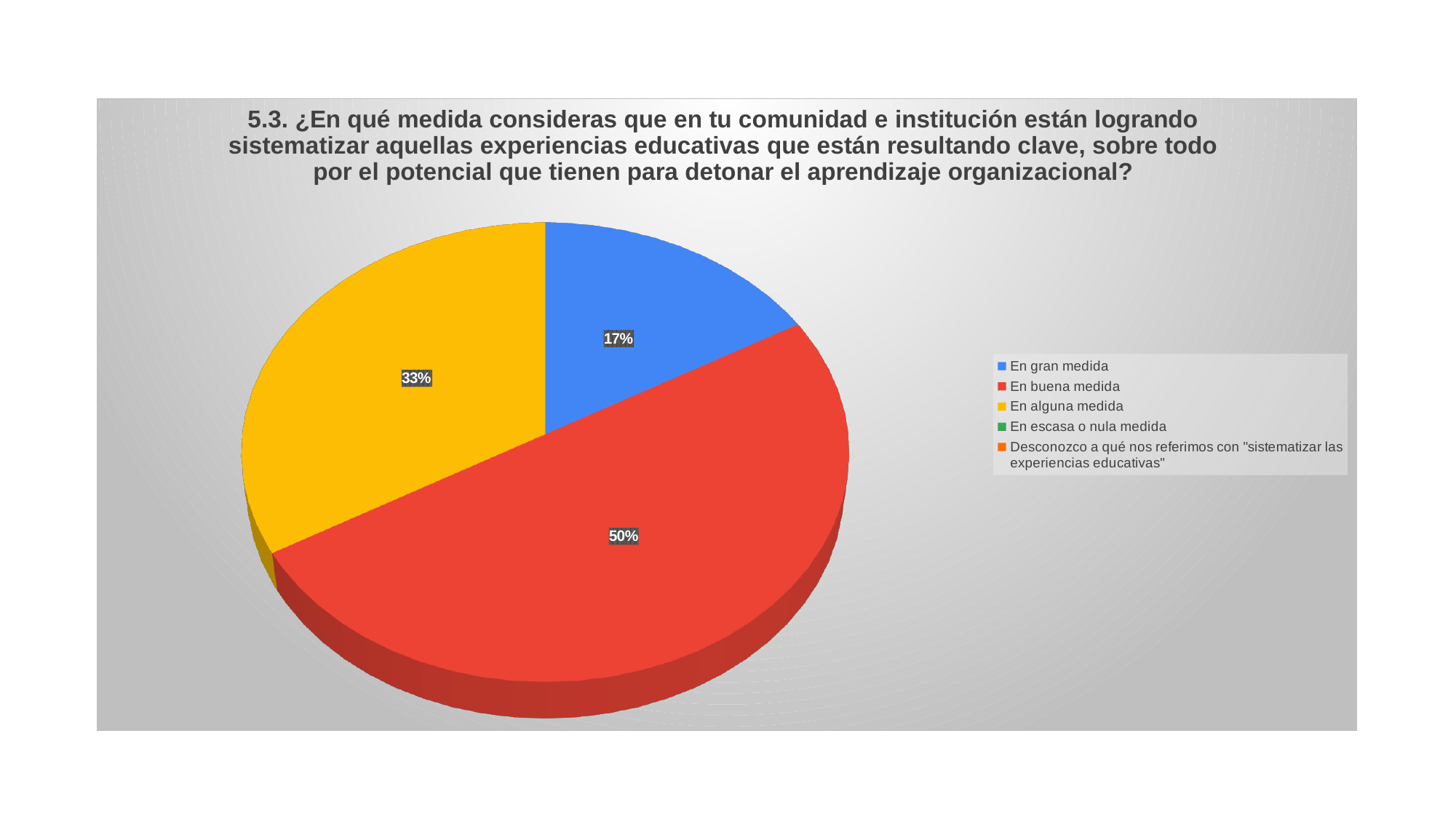
How many entries does the legend list? 5 Which is larger, the slice for "En alguna medida" or the slice for "En gran medida"? En alguna medida What colour is the slice for "En alguna medida"? Yellow What is the difference in percentage points between "En alguna medida" and "En gran medida"? 16 What share of the pie does "En buena medida" represent? 50% What share of the pie does "En alguna medida" represent? 33% What is the difference in percentage points between "En buena medida" and "En gran medida"? 33 What kind of chart is shown on the slide? Pie chart What share of the pie does "En gran medida" represent? 17% Which category has the largest slice of the pie? En buena medida Which of the three labelled slices is the smallest? En gran medida How many slices with data labels are visible in the pie? 3